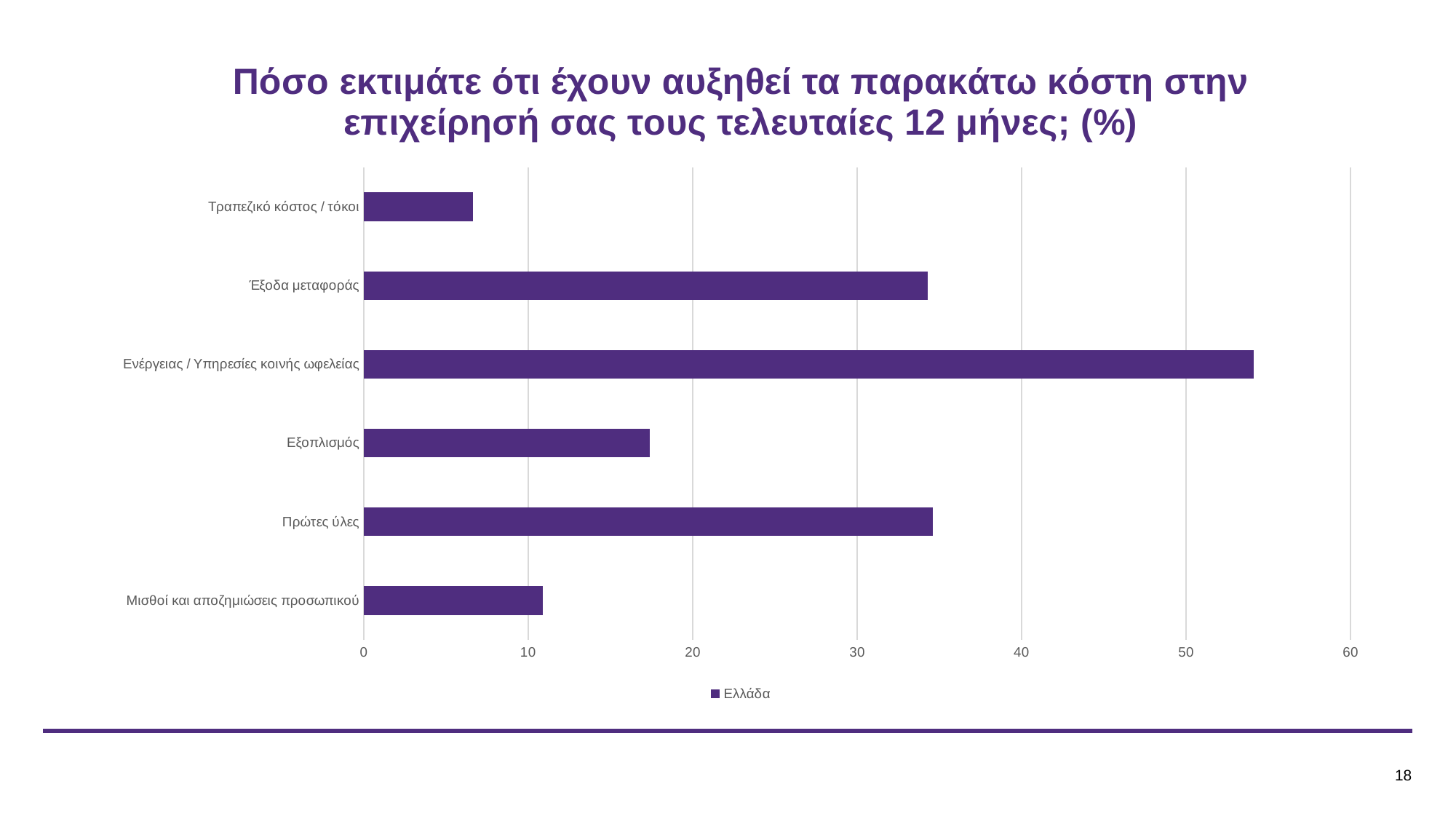
How many categories are plotted in the chart? 6 What is the name of the series shown in the legend? Ελλάδα Which category has the highest value? Ενέργειας / Υπηρεσίες κοινής ωφελείας Is the value for Εξοπλισμός greater or less than 20? less Which is larger, the value for Μισθοί και αποζημιώσεις προσωπικού or the value for Έξοδα μεταφοράς? Έξοδα μεταφοράς How many series does the legend list? 1 Is the value for Μισθοί και αποζημιώσεις προσωπικού greater or less than 10? greater Which is larger, the value for Εξοπλισμός or the value for Πρώτες ύλες? Πρώτες ύλες Which category has the lowest value? Τραπεζικό κόστος / τόκοι What kind of chart is shown on the slide? Bar chart Is the value for Τραπεζικό κόστος / τόκοι greater or less than 10? less